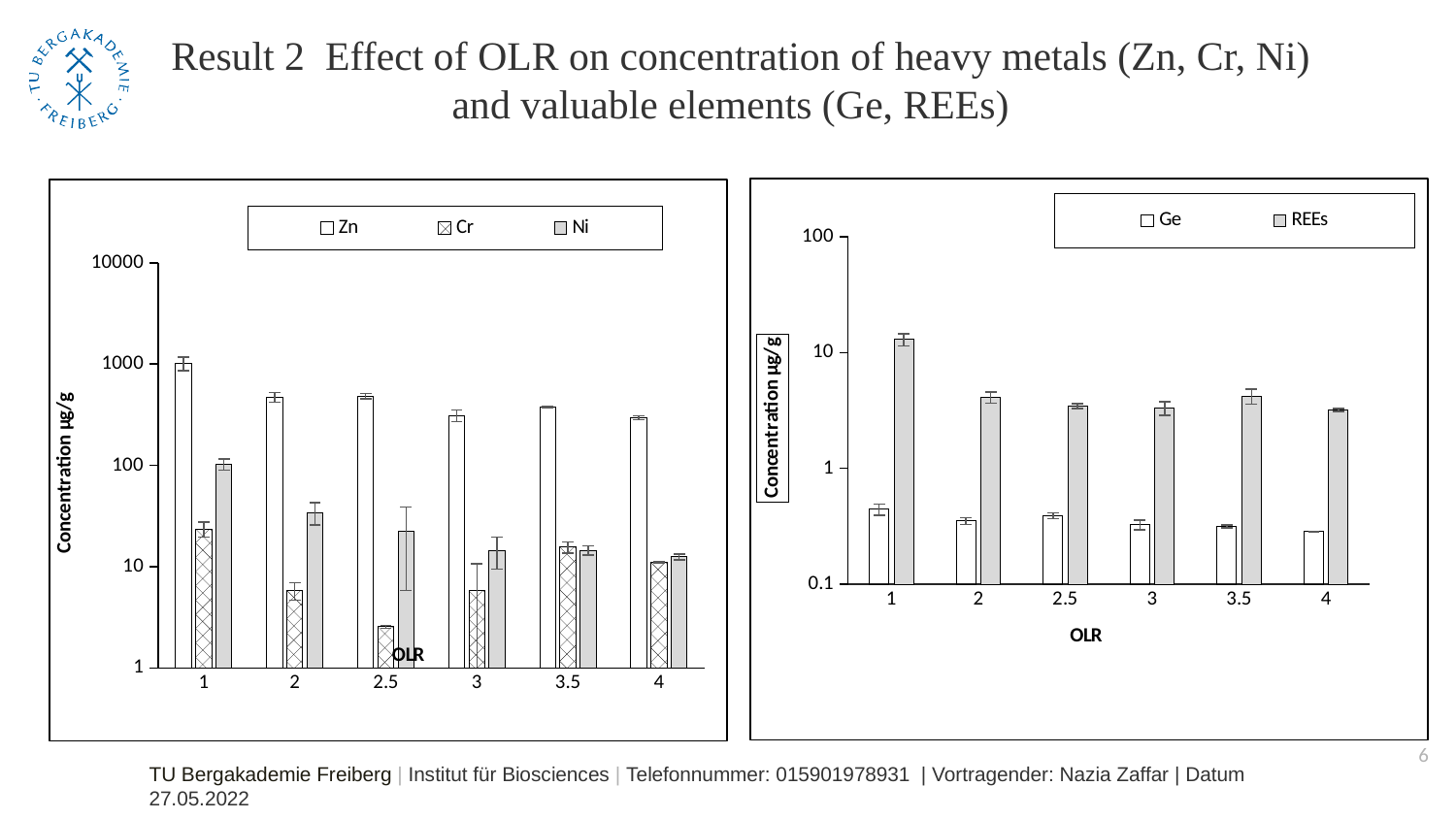
What kind of chart is the left chart (Zn, Cr, Ni)? bar chart How many series does the legend of the left chart list? 3 In the right chart, at which OLR value is the REEs concentration highest? 1 What is the x-axis label of the right chart? OLR In the right chart, which is larger at OLR 3: the Ge concentration or the REEs concentration? REEs How many OLR categories are shown on the x axis of the right chart (Ge, REEs)? 6 In the left chart, at which OLR value is the Cr concentration lowest? 2.5 In the left chart, which is larger at OLR 2: the Zn concentration or the Ni concentration? Zn In the left chart, is the Zn concentration at OLR 4 greater or less than 100? greater In the left chart, at which OLR value is the Zn concentration highest? 1 In the left chart, is the Cr concentration at OLR 2.5 greater or less than 10? less In the right chart, is the REEs concentration at OLR 1 greater or less than 10? greater